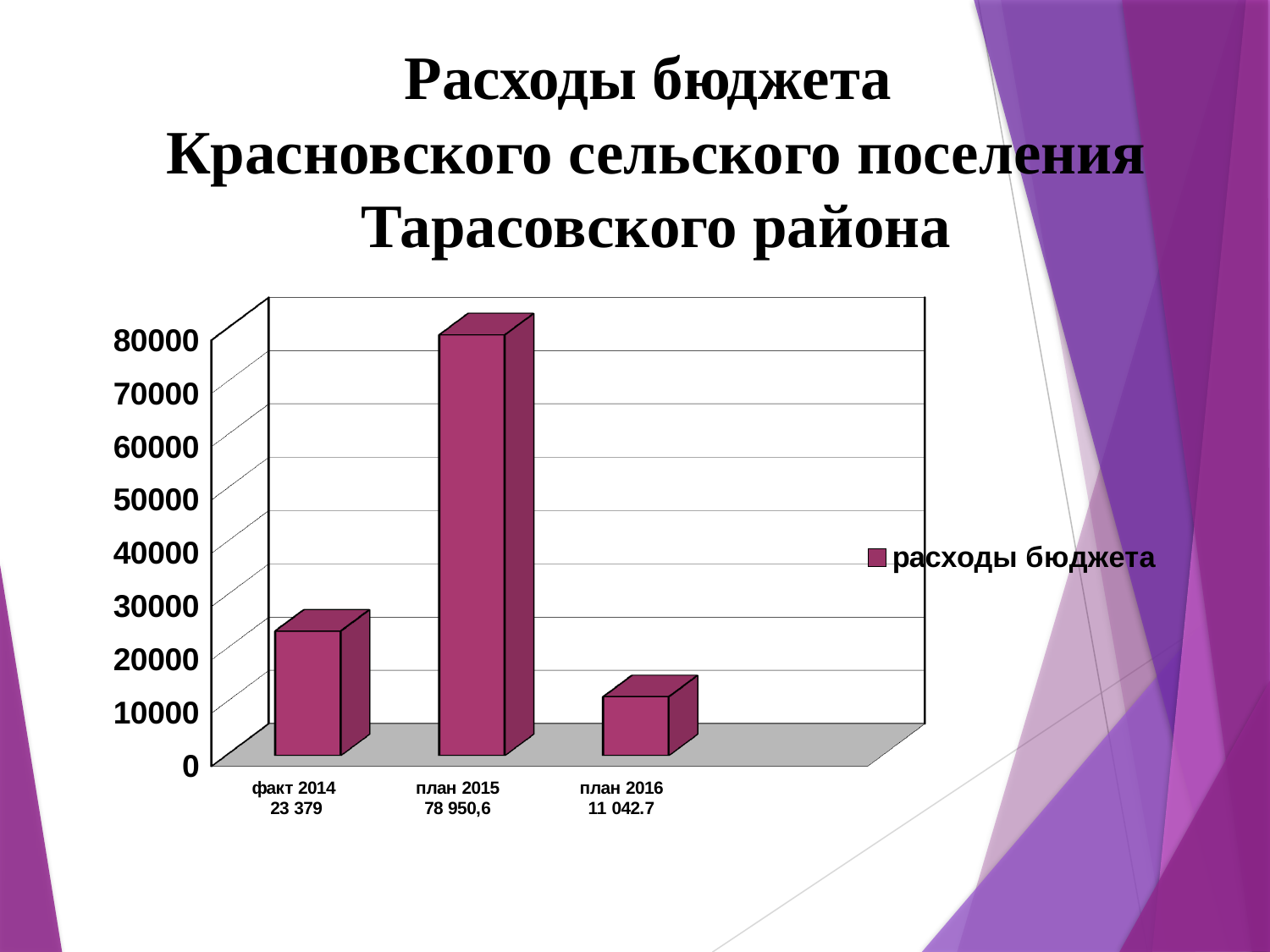
What is the value for факт 2014? 23 379 What is the value for план 2015? 78 950,6 How many categories are shown on the x axis? 3 Is the value for план 2016 greater or less than 20000? less What is the difference between the values for план 2015 and факт 2014? 55 571,6 What kind of chart is shown on the slide? bar chart Which is larger, the value for факт 2014 or the value for план 2016? факт 2014 Which category has the lowest value? план 2016 What series name does the legend show? расходы бюджета Is the value for план 2015 greater or less than 70000? greater Which category has the highest value? план 2015 What is the value for план 2016? 11 042.7